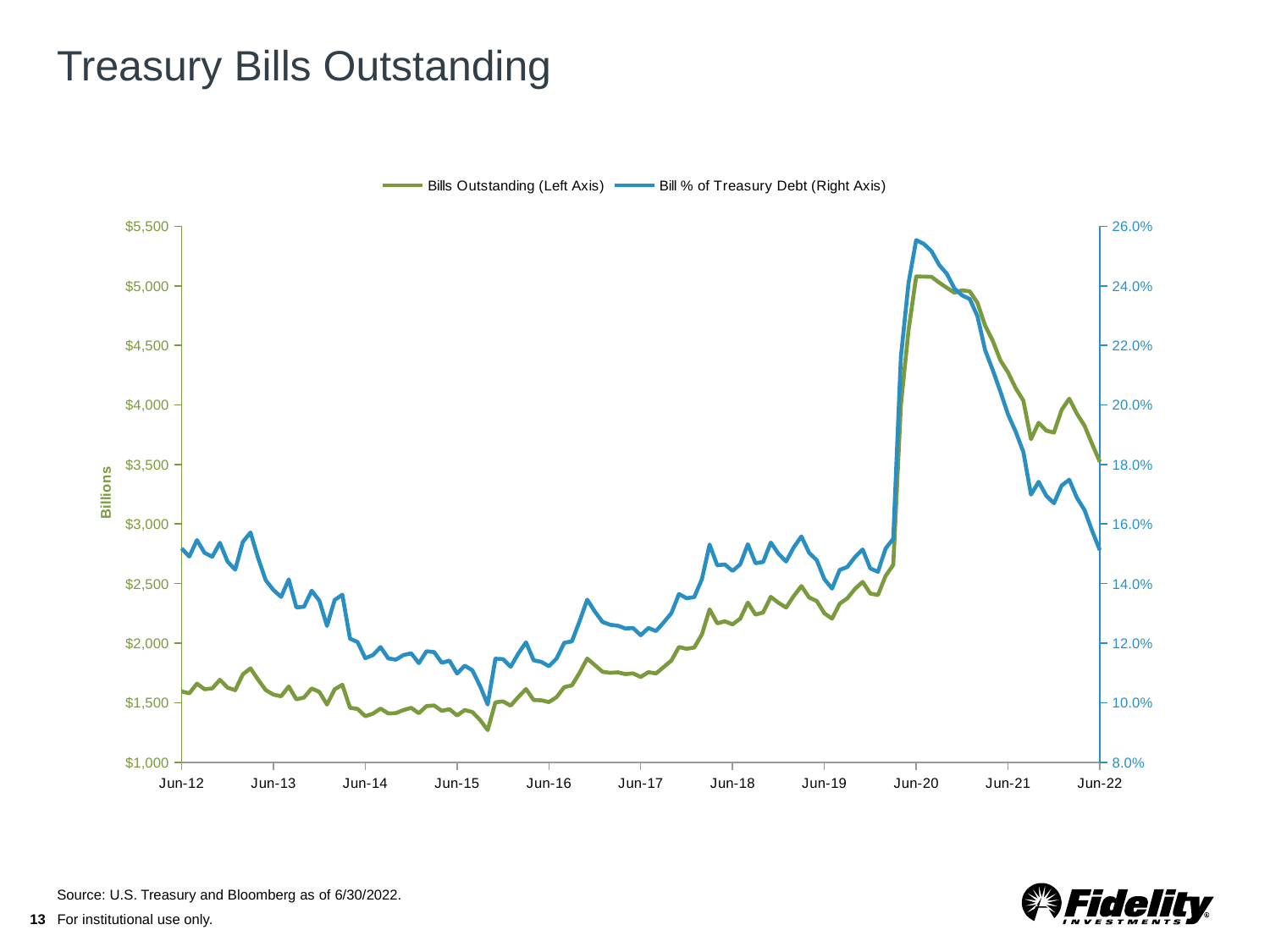
How many date labels are shown along the x axis? 11 Is the value of Bill % of Treasury Debt at Jun-22 greater or less than 16.0%? less Is the value of Bills Outstanding at Jun-22 greater or less than $3,000? greater Is the value of Bill % of Treasury Debt at Jun-12 greater or less than 14.0%? greater What kind of chart is shown on the slide? Line chart How many series does the legend list? 2 Does the Bill % of Treasury Debt line rise or fall between Jun-12 and Jun-15? fall Which series is plotted against the right axis? Bill % of Treasury Debt Does the Bills Outstanding line rise or fall between Jun-20 and Jun-22? fall What is the title of the chart? Treasury Bills Outstanding Near which x-axis label does the Bills Outstanding line reach its highest point? Jun-20